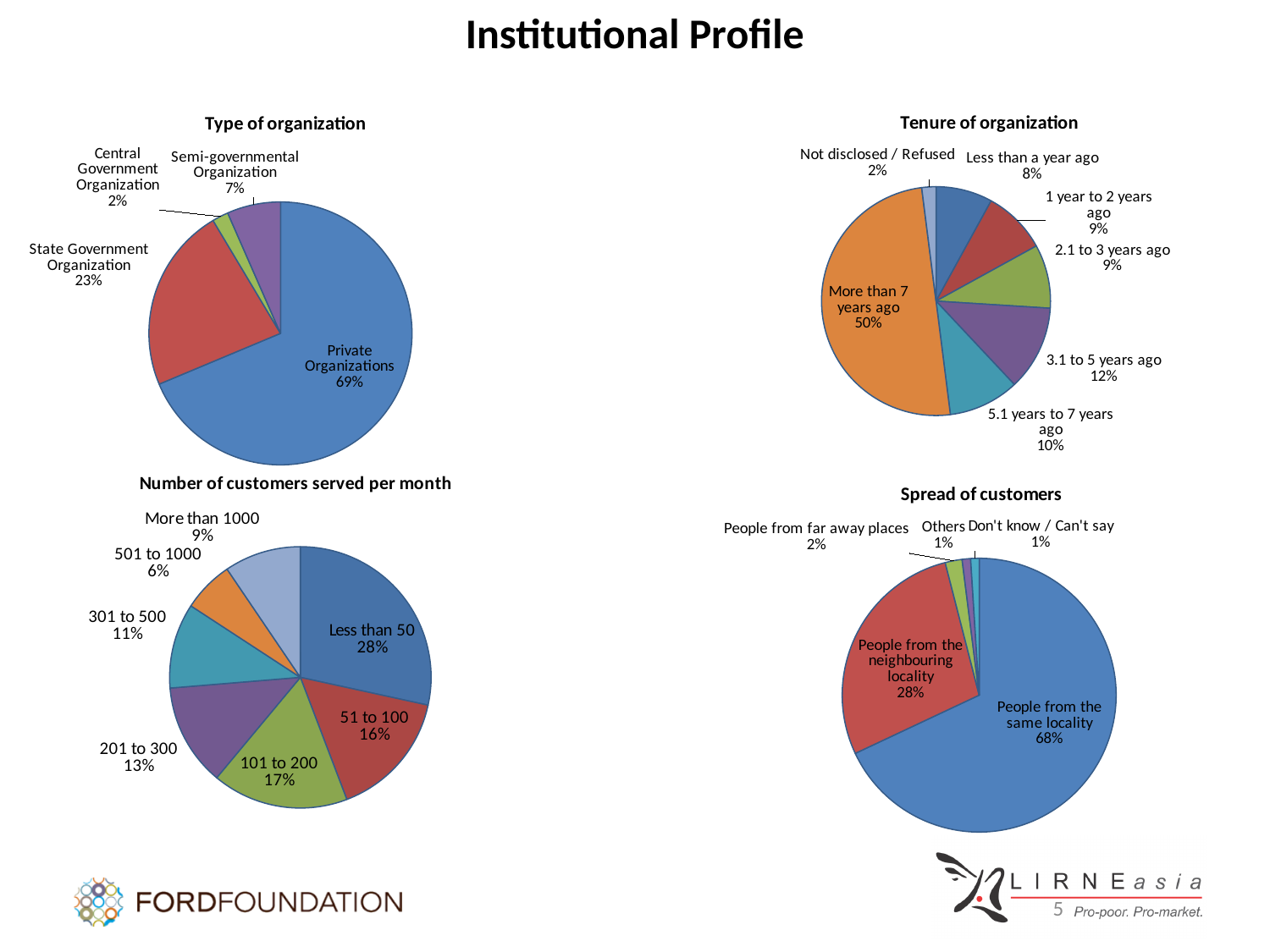
In the 'Spread of customers' chart, what share is 'People from the neighbouring locality'? 28% In the 'Tenure of organization' chart, what is the difference between '3.1 to 5 years ago' and '5.1 years to 7 years ago'? 2% How many pie charts are on the slide? 4 In the 'Number of customers served per month' chart, which category has the largest share? Less than 50 In the 'Tenure of organization' chart, what share is 'More than 7 years ago'? 50% In the 'Spread of customers' chart, what is the difference between 'People from the same locality' and 'People from the neighbouring locality'? 40% In the 'Type of organization' chart, which category has the smallest share? Central Government Organization In the 'Tenure of organization' chart, how many categories are shown? 7 In the 'Number of customers served per month' chart, which is larger: '301 to 500' or '501 to 1000'? 301 to 500 In the 'Number of customers served per month' chart, what share is '101 to 200'? 17% In the 'Type of organization' chart, what share is Private Organizations? 69% What type of chart is the 'Spread of customers' chart? Pie chart